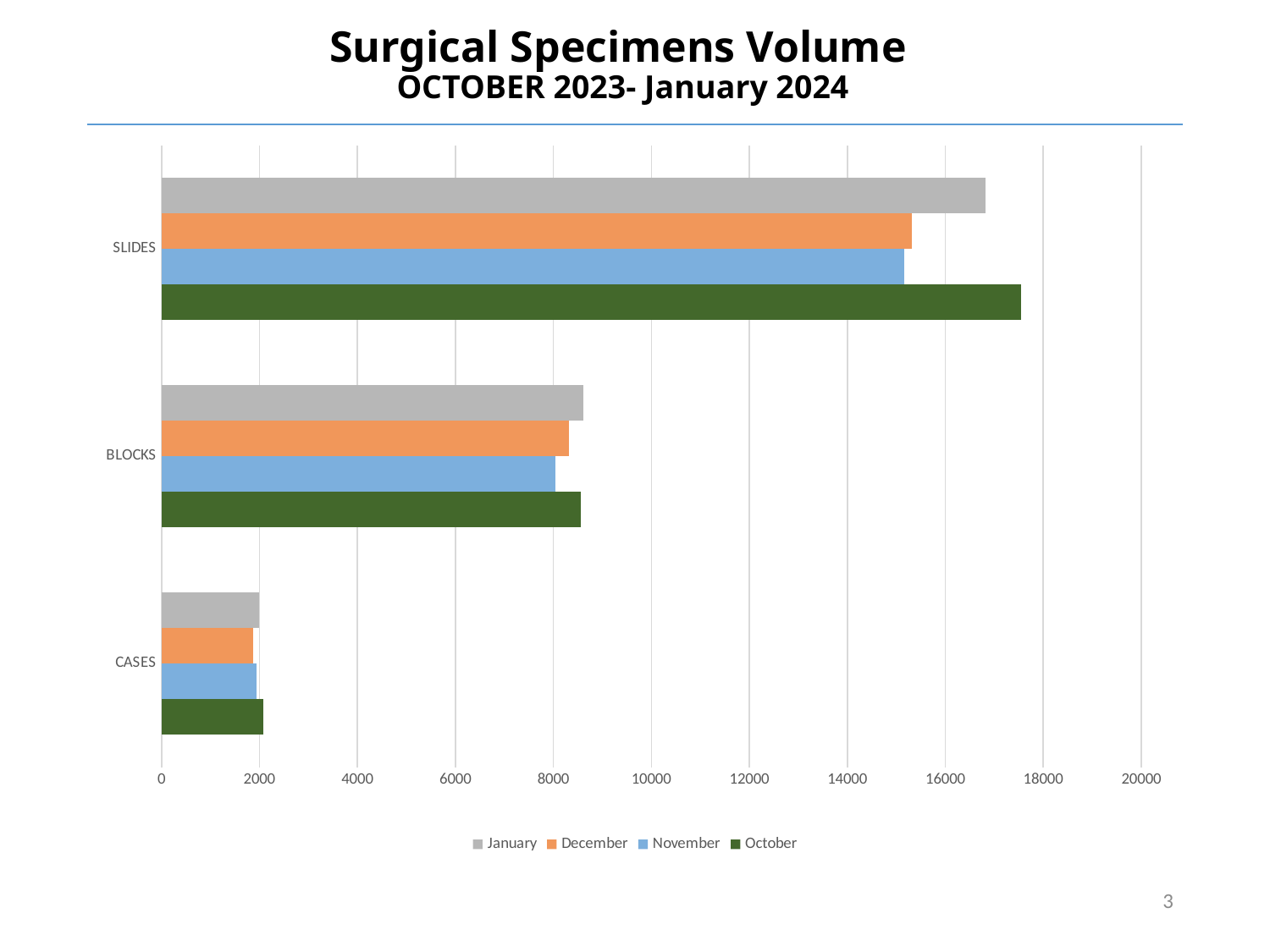
Is the January value for BLOCKS greater or less than 8000? greater Is the November value for SLIDES greater or less than 16000? less What kind of chart is shown on the slide? bar chart How many categories are shown on the vertical axis of the chart? 3 Which category has the highest values overall in the chart? SLIDES What is the title of the chart? Surgical Specimens Volume OCTOBER 2023- January 2024 How many series does the legend list? 4 Which month has the highest value for SLIDES? October Is the October value for SLIDES greater or less than 16000? greater For SLIDES, which is larger: the January value or the December value? January Which category has the lowest values overall in the chart? CASES